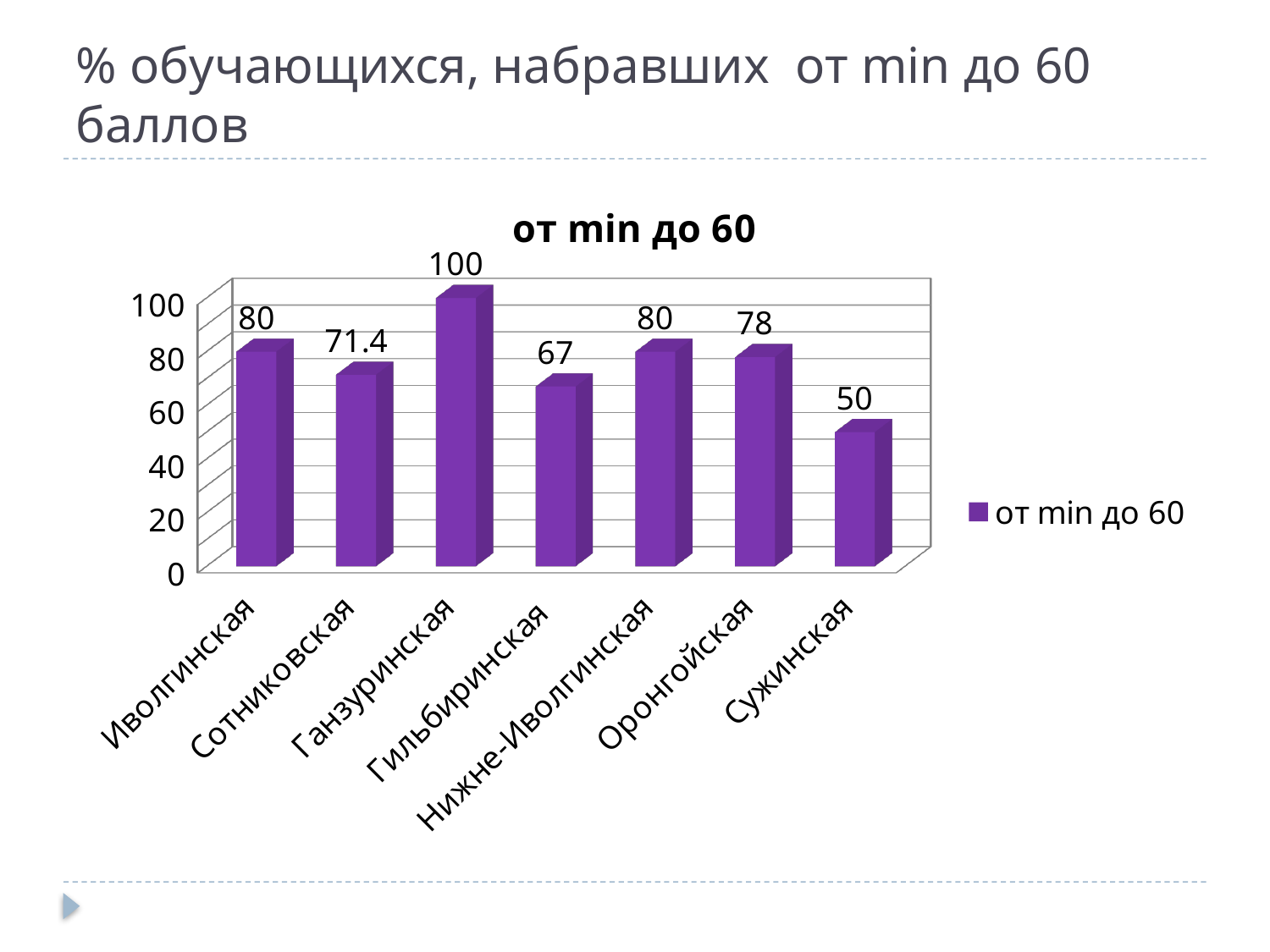
Which category has the lowest value? Сужинская Which category has the highest value? Ганзуринская Is the value for Сужинская greater or less than 60? less What is the difference between the values for Ганзуринская and Сужинская? 50 What is the difference between the values for Иволгинская and Гильбиринская? 13 What is the value for Оронгойская? 78 What is the value for Сотниковская? 71.4 Which is larger, the value for Оронгойская or the value for Гильбиринская? Оронгойская What is the value for Ганзуринская? 100 What kind of chart is shown on the slide? bar chart What is the title of the chart? от min до 60 How many categories are shown on the x axis? 7